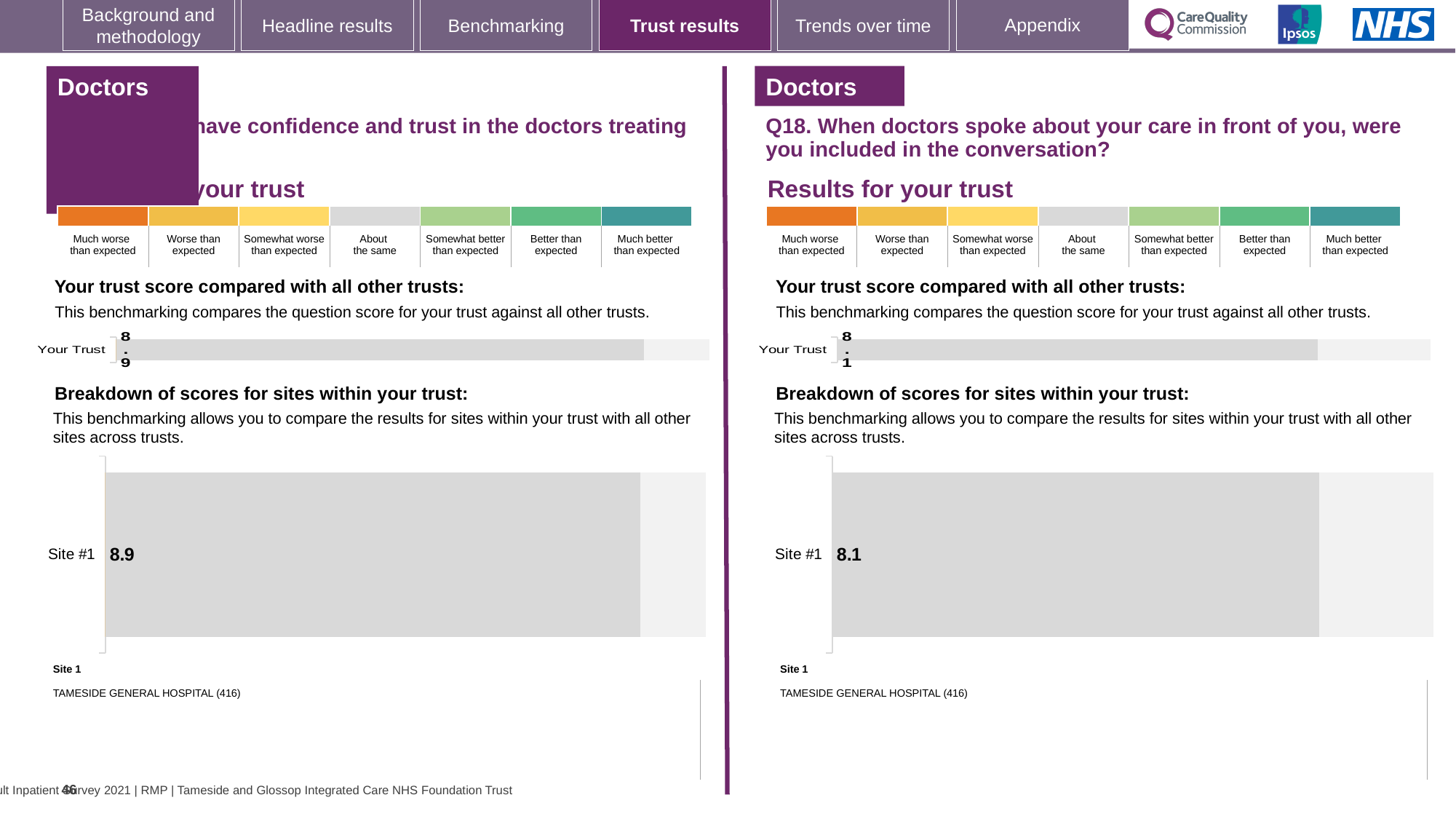
How many sites are shown in the left-hand site breakdown chart? 1 On the left-hand site breakdown chart, what is the score for Site #1? 8.9 Which is larger: the Your Trust score on the left-hand chart or the Your Trust score on the right-hand chart for Q18? The left-hand chart How many rating categories are shown in the colour scale above the left-hand chart, from 'Much worse than expected' to 'Much better than expected'? 7 Which hospital is listed as Site 1 under the right-hand site breakdown chart for Q18? TAMESIDE GENERAL HOSPITAL (416) What kind of chart is used to show the Your Trust score on the right-hand side for Q18? Bar chart On the right-hand chart for Q18, is the Site #1 score greater or less than 8? greater On the left-hand chart, what is the score shown for Your Trust? 8.9 On the right-hand site breakdown chart for Q18, what is the score for Site #1? 8.1 On the right-hand chart for Q18, what is the score shown for Your Trust? 8.1 What is the difference between the Site #1 score on the left-hand chart and the Site #1 score on the right-hand chart for Q18? 0.8